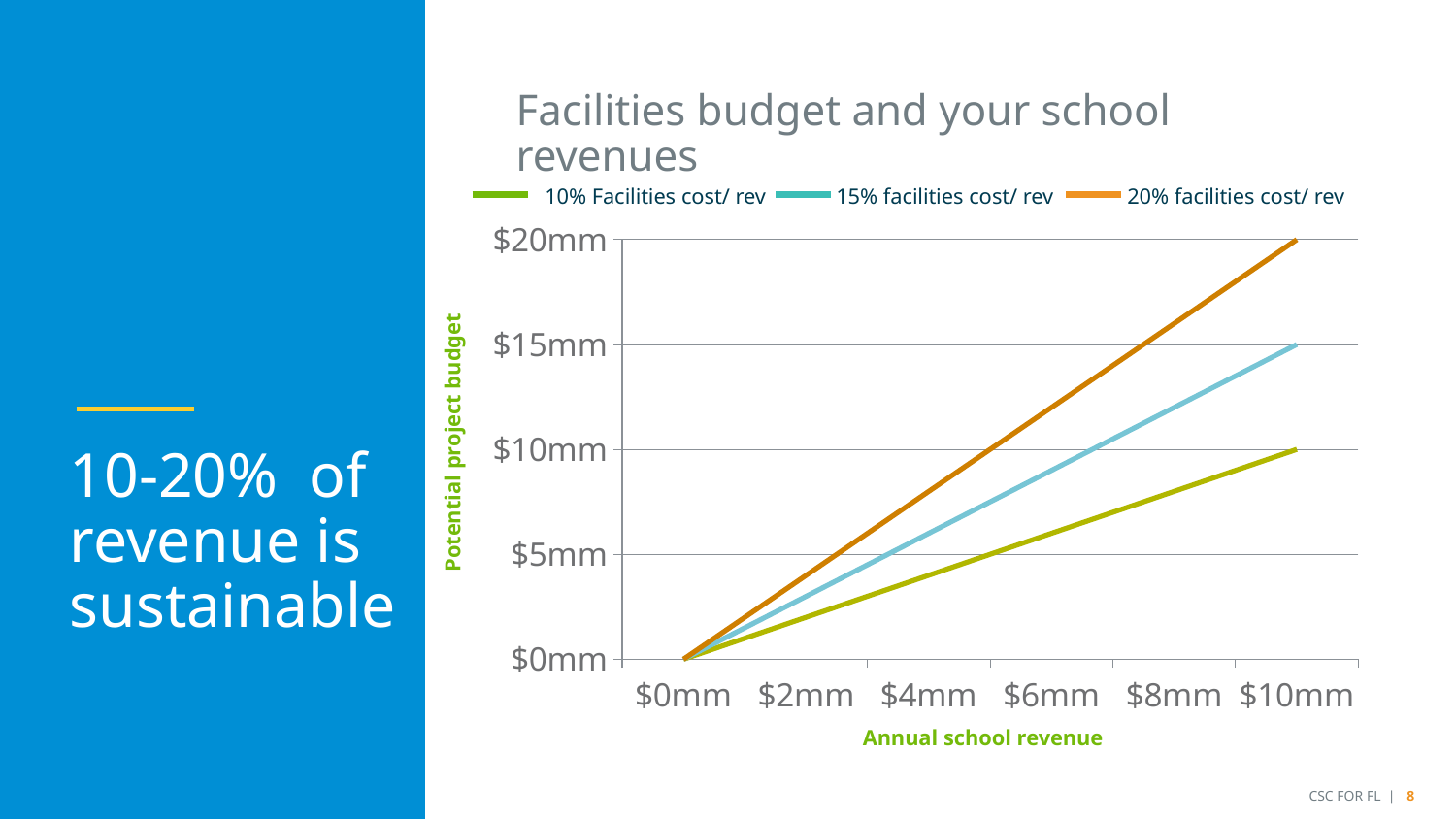
Is the value for the 20% facilities cost/ rev series at $6mm annual school revenue greater or less than $10mm? greater What is the potential project budget for the 20% facilities cost/ rev series at $10mm annual school revenue? $20mm What is the difference between the 20% facilities cost/ rev and 10% Facilities cost/ rev potential project budgets at $10mm annual school revenue? $10mm What is the title of the chart? Facilities budget and your school revenues What is the label of the x axis? Annual school revenue What is the potential project budget for the 10% Facilities cost/ rev series at $10mm annual school revenue? $10mm What kind of chart is shown on the slide? Line chart Which series has the lowest potential project budget at $10mm annual school revenue? 10% Facilities cost/ rev What is the potential project budget for the 15% facilities cost/ rev series at $10mm annual school revenue? $15mm How many series does the chart legend list? 3 Do the lines rise or fall as annual school revenue increases? Rise Which series has the highest potential project budget at $10mm annual school revenue? 20% facilities cost/ rev